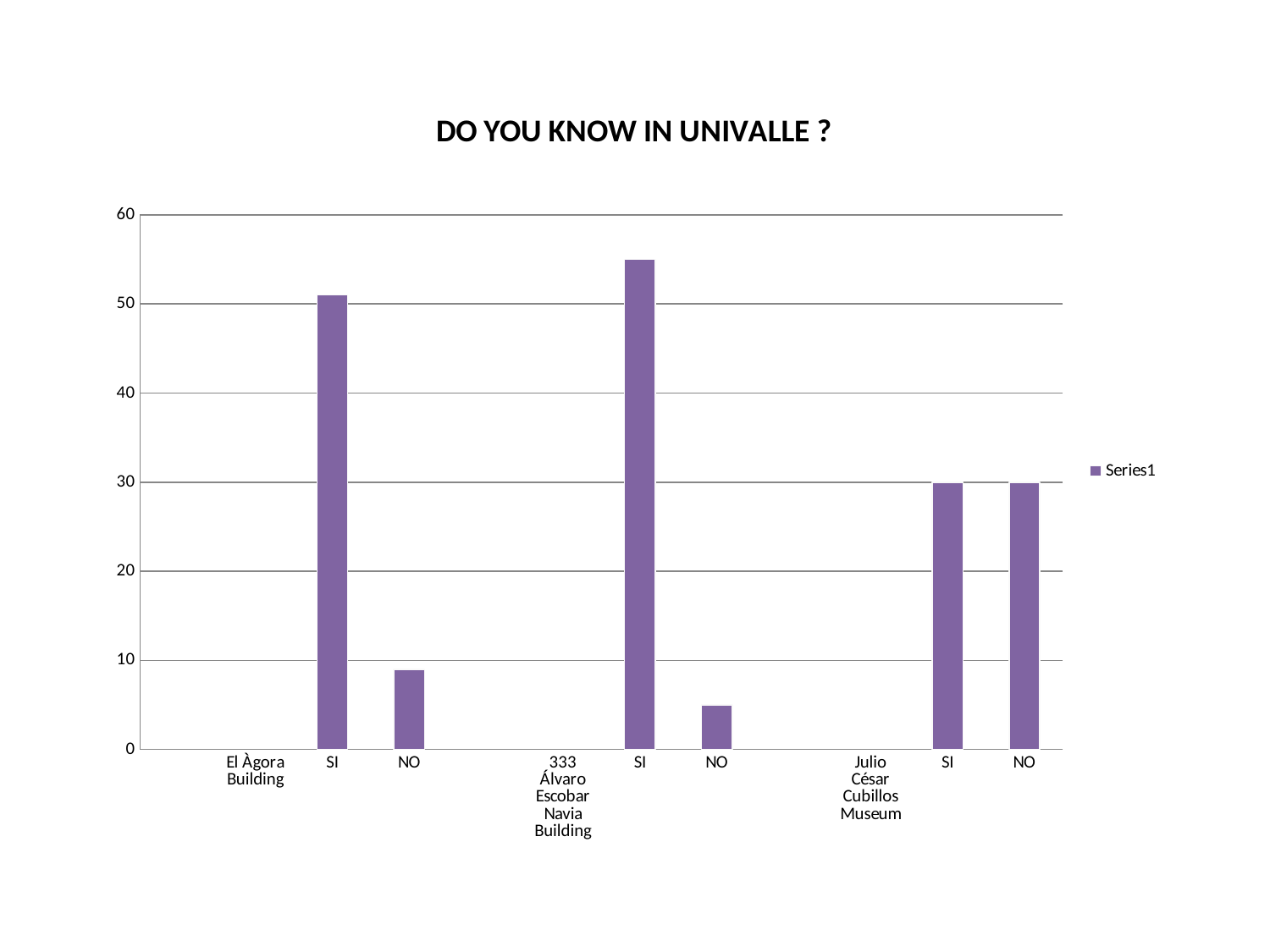
What is the value of the NO bar for the Julio César Cubillos Museum? 30 What is the value of the SI bar for the Julio César Cubillos Museum? 30 Which is larger: the SI bar for El Àgora Building or the SI bar for the Julio César Cubillos Museum? SI for El Àgora Building Is the value of the NO bar for El Àgora Building greater or less than 10? less Which bar is the tallest in the chart? SI for the 333 Álvaro Escobar Navia Building What is the name of the series shown in the legend? Series1 Is the value of the SI bar for the 333 Álvaro Escobar Navia Building greater or less than 50? greater Which bar is the shortest in the chart? NO for the 333 Álvaro Escobar Navia Building How many series does the legend list? 1 What is the title of the chart? DO YOU KNOW IN UNIVALLE ? Is the value of the SI bar for El Àgora Building greater or less than 50? greater What kind of chart is shown on the slide? bar chart